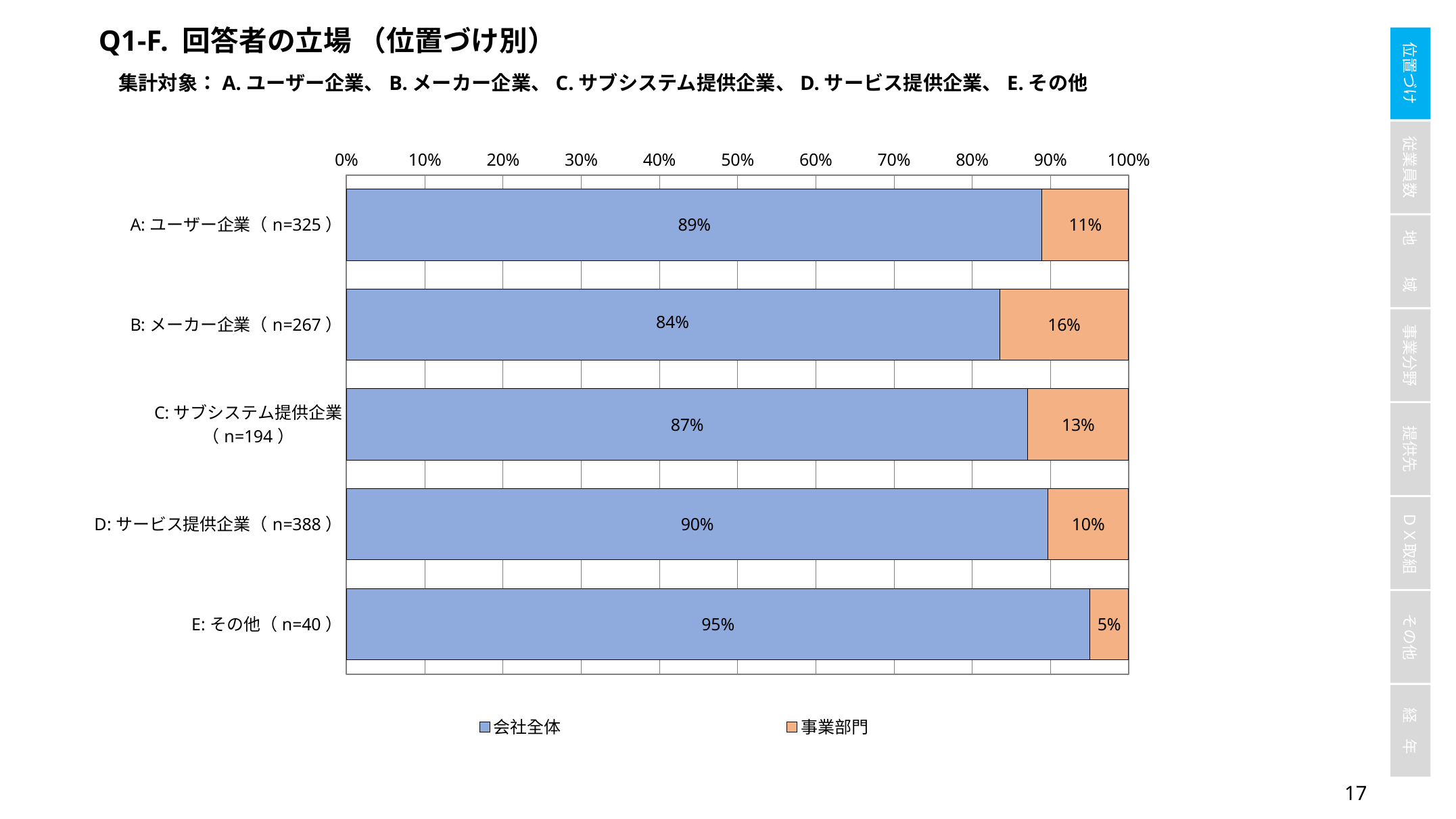
Which category has the lowest 会社全体 value? B: メーカー企業 (n=267) What is the 事業部門 value for E: その他 (n=40)? 5% Which category has the highest 会社全体 value? E: その他 (n=40) What is the 会社全体 value for A: ユーザー企業 (n=325)? 89% What is the 事業部門 value for B: メーカー企業 (n=267)? 16% How many series does the legend list? 2 How many categories are shown on the chart? 5 Which is larger, the 会社全体 value for A: ユーザー企業 or for D: サービス提供企業? D: サービス提供企業 What is the difference between the 事業部門 values for B: メーカー企業 and D: サービス提供企業? 6% What kind of chart is shown on the slide? Stacked bar chart What is the total of the stacked bar for C: サブシステム提供企業 (n=194)? 100% What is the 会社全体 value for C: サブシステム提供企業 (n=194)? 87%